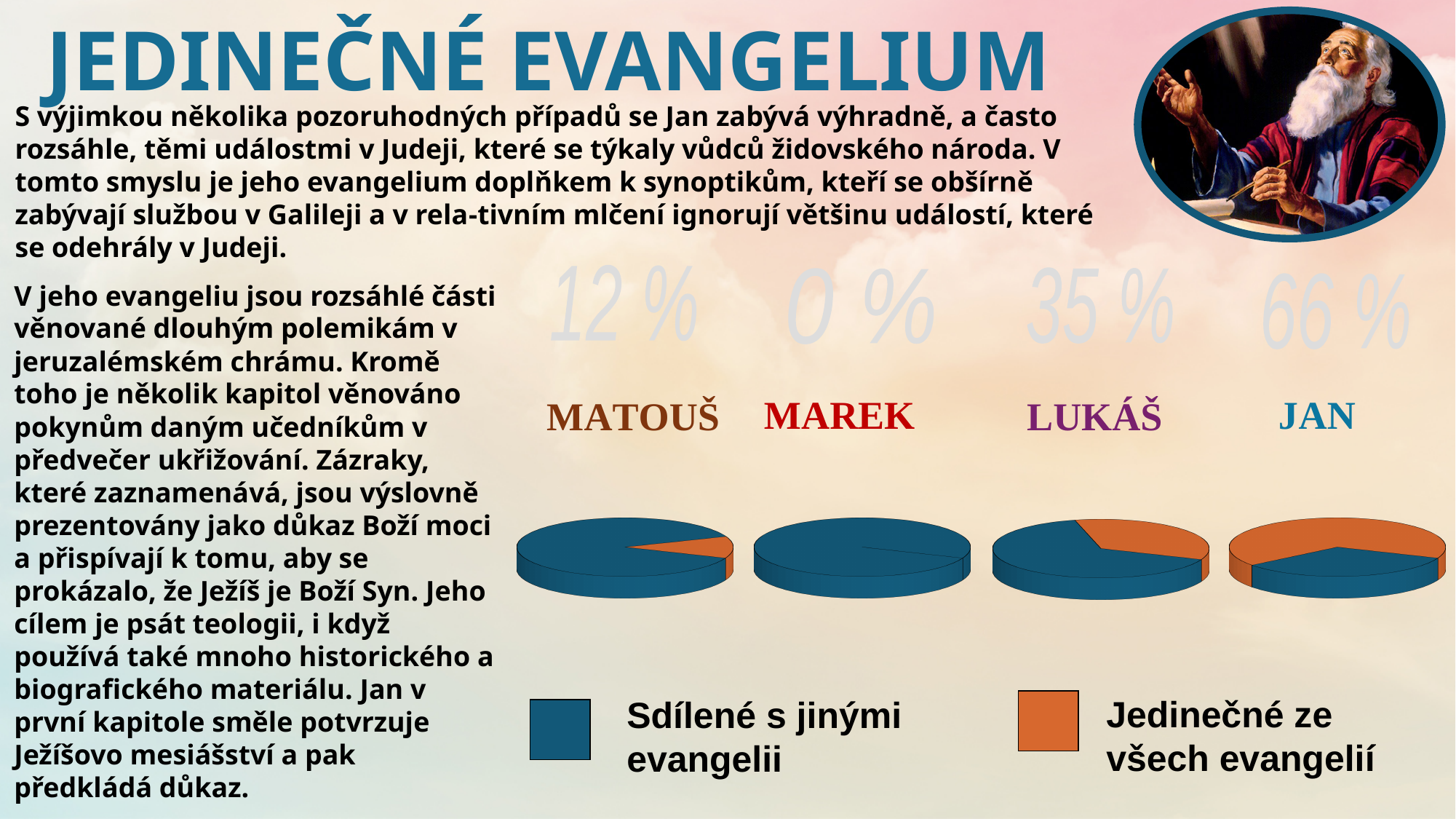
Which colour in the legend represents 'Jedinečné ze všech evangelií'? Orange In the pie chart for JAN, what percentage is unique to that gospel? 66 % In the pie chart for LUKÁŠ, what percentage is unique to that gospel? 35 % Across the four pie charts, which gospel has the smallest unique share? MAREK Which gospel has a larger unique share, LUKÁŠ or MATOUŠ? LUKÁŠ In the pie chart for MATOUŠ, what percentage is unique to that gospel (Jedinečné ze všech evangelií)? 12 % In the pie chart for MAREK, what percentage is unique to that gospel? 0 % Across the four pie charts, which gospel has the largest unique share? JAN What kind of chart is used to show the data for each gospel? Pie chart How many pie charts are shown on the slide? 4 How much larger is the unique share for JAN than for LUKÁŠ? 31 %